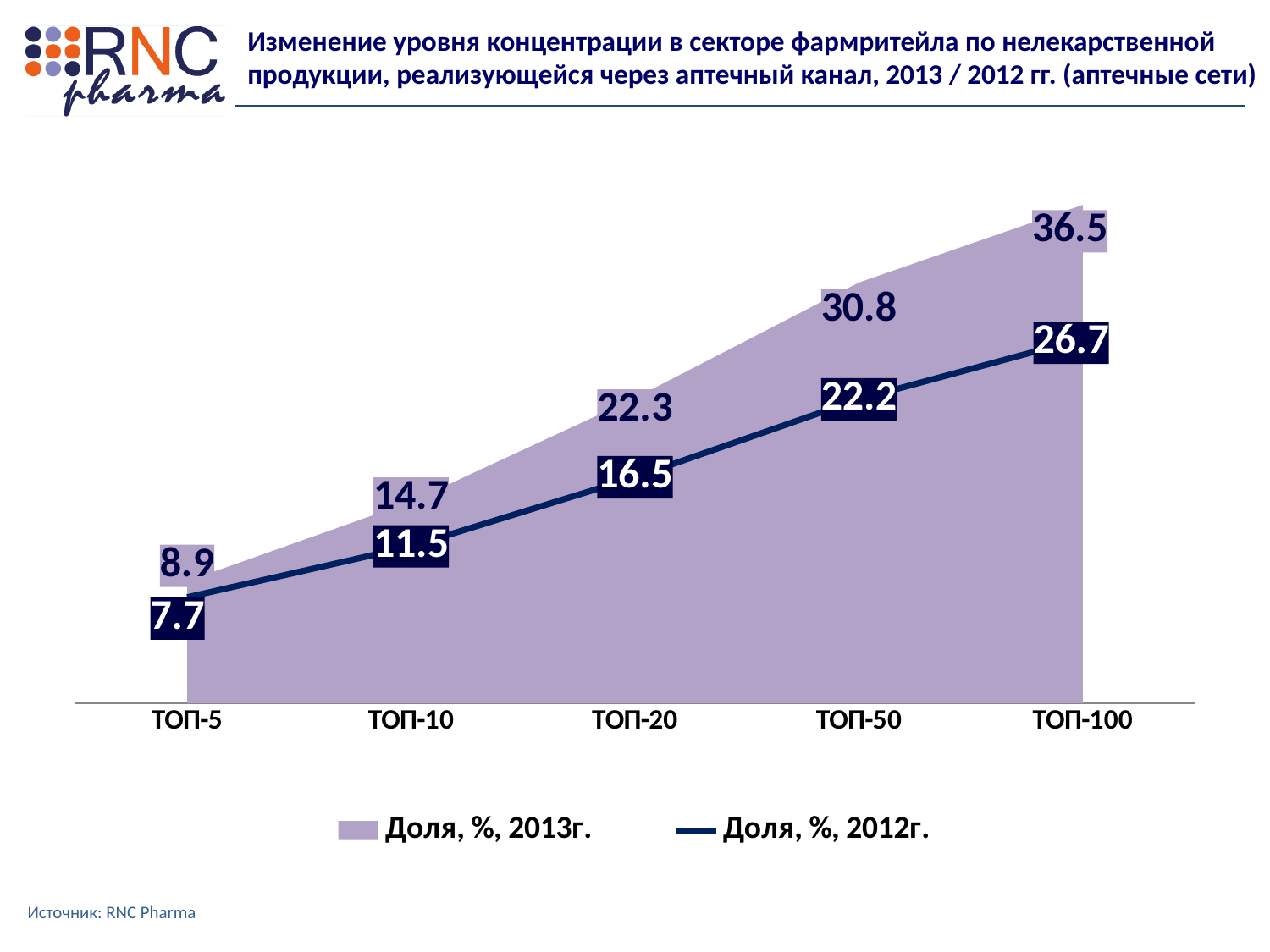
How many series does the legend list? 2 Do the values for Доля, %, 2012г. rise or fall from ТОП-5 to ТОП-100? rise What is the value of Доля, %, 2012г. for ТОП-5? 7.7 Which category has the lowest value for Доля, %, 2013г.? ТОП-5 What is the value of Доля, %, 2013г. for ТОП-100? 36.5 Which is larger for ТОП-10: the 2013 share or the 2012 share? 2013 share (14.7) What is the difference between the 2013 and 2012 share values for ТОП-100? 9.8 What is the value of Доля, %, 2012г. for ТОП-50? 22.2 What is the value of Доля, %, 2013г. for ТОП-20? 22.3 Which category has the highest value for Доля, %, 2012г.? ТОП-100 What is the difference between the 2013 share for ТОП-50 and the 2013 share for ТОП-10? 16.1 How many categories are shown on the x axis? 5